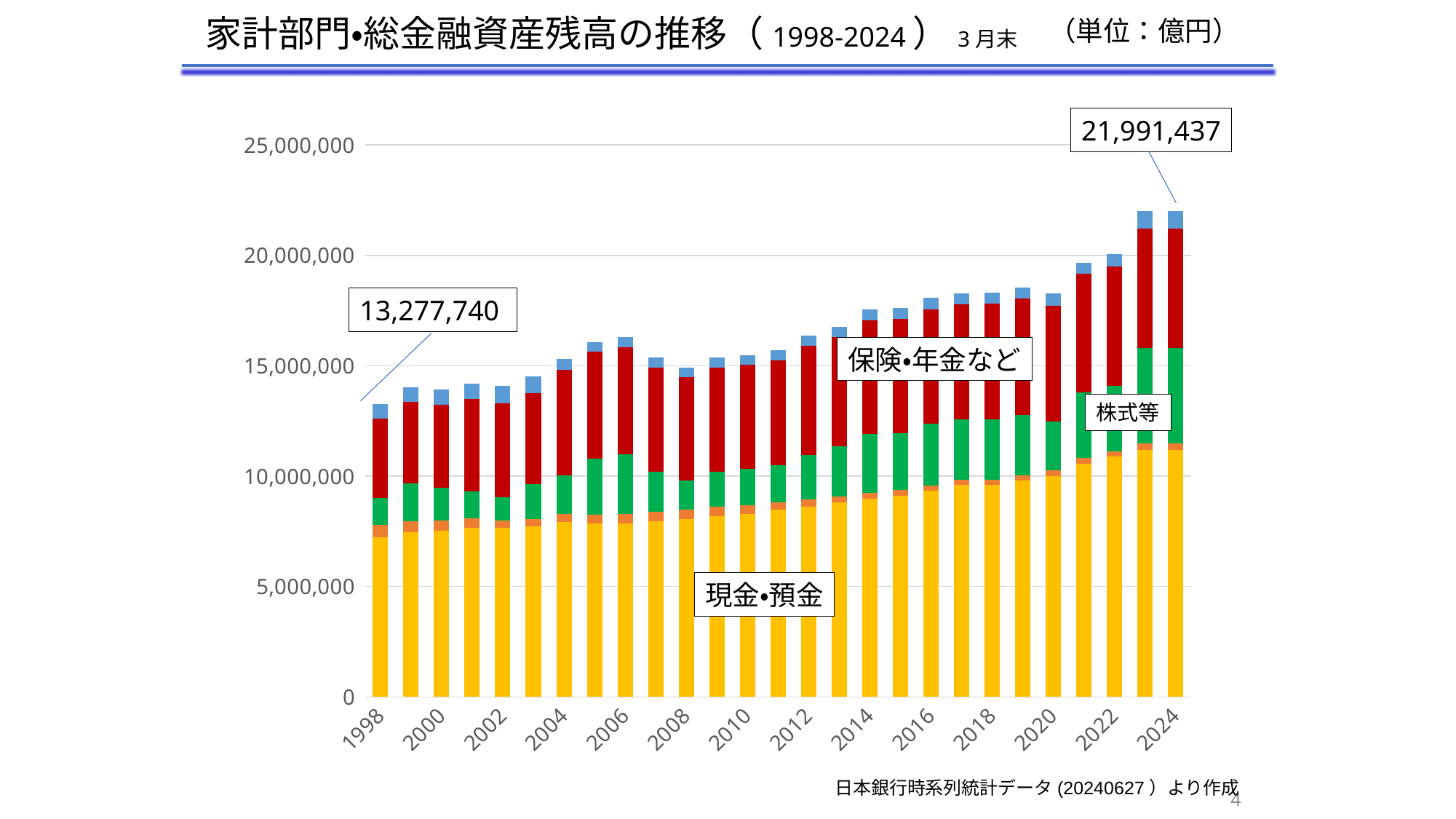
What unit is stated for the values in the chart? 億円 What kind of chart is shown on the slide? Stacked bar chart What is the total household financial asset balance shown for 1998? 13,277,740 Which year has the larger total, 2020 or 2021? 2021 What is the difference between the 2024 total (21,991,437) and the 1998 total (13,277,740)? 8,713,697 Is the total for 2016 greater or less than 15,000,000? greater Is the total for 2021 greater or less than 20,000,000? less What is the total household financial asset balance shown for 2024? 21,991,437 Which asset category forms the bottom (yellow) segment of each bar? 現金・預金 Which year has the lowest total financial asset balance? 1998 How many years (bars) are plotted in the chart? 27 Do the total balances generally rise or fall from 1998 to 2024? rise